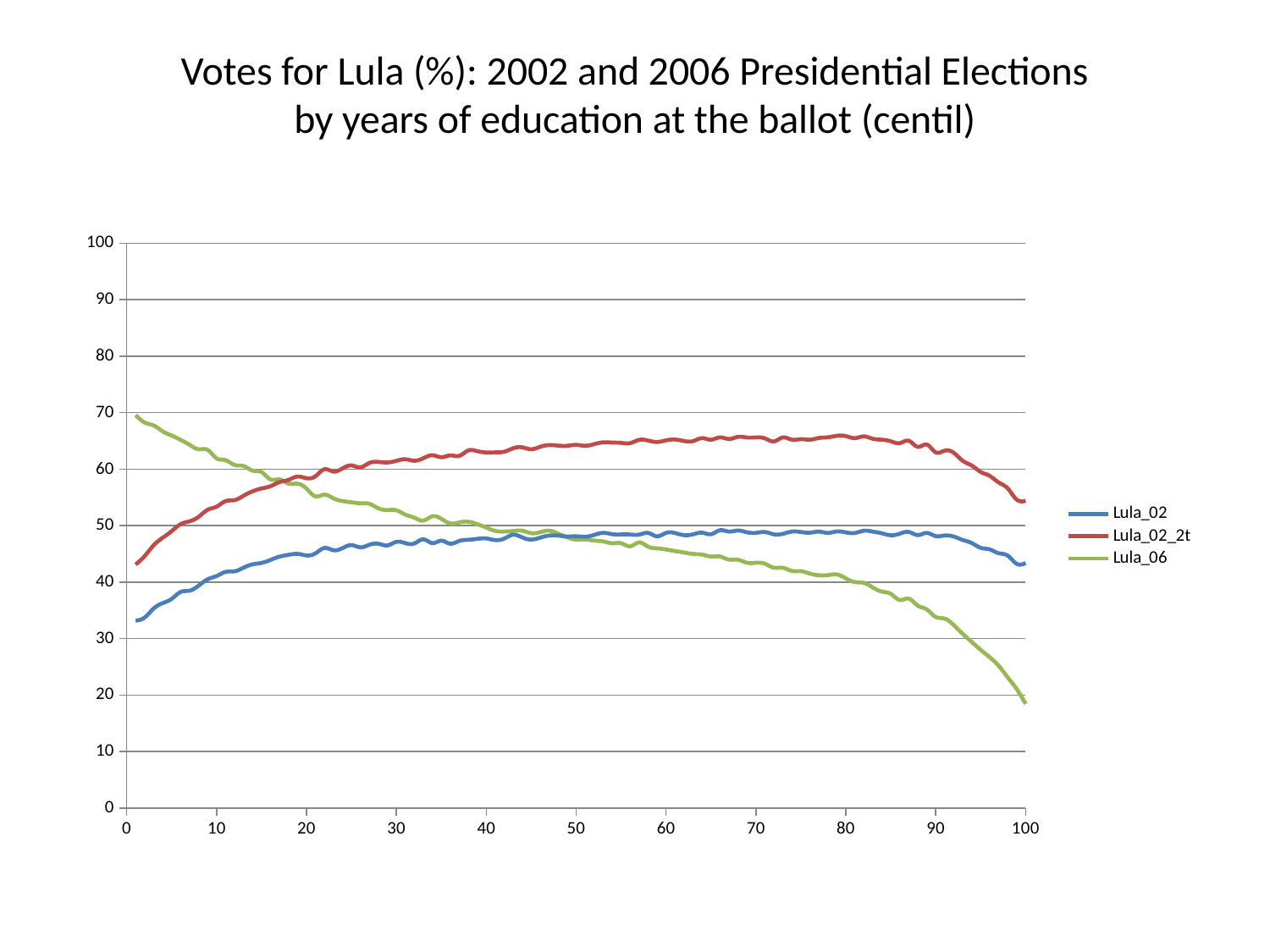
At centil 10, which series has the higher value, Lula_02 or Lula_02_2t? Lula_02_2t How many series does the legend list? 3 Is the value of Lula_02 at centil 1 greater or less than 40? less Does the Lula_02 line rise or fall between centil 0 and centil 50? rise Is the value of Lula_06 at centil 100 greater or less than 30? less Is the value of Lula_06 at centil 1 greater or less than 60? greater Does the Lula_06 line rise or fall as the centil increases along the x axis? fall What is the title of the chart? Votes for Lula (%): 2002 and 2006 Presidential Elections by years of education at the ballot (centil) What kind of chart is shown on the slide? line chart What are the names of the series listed in the legend? Lula_02, Lula_02_2t, Lula_06 Which series has the lowest value at centil 100? Lula_06